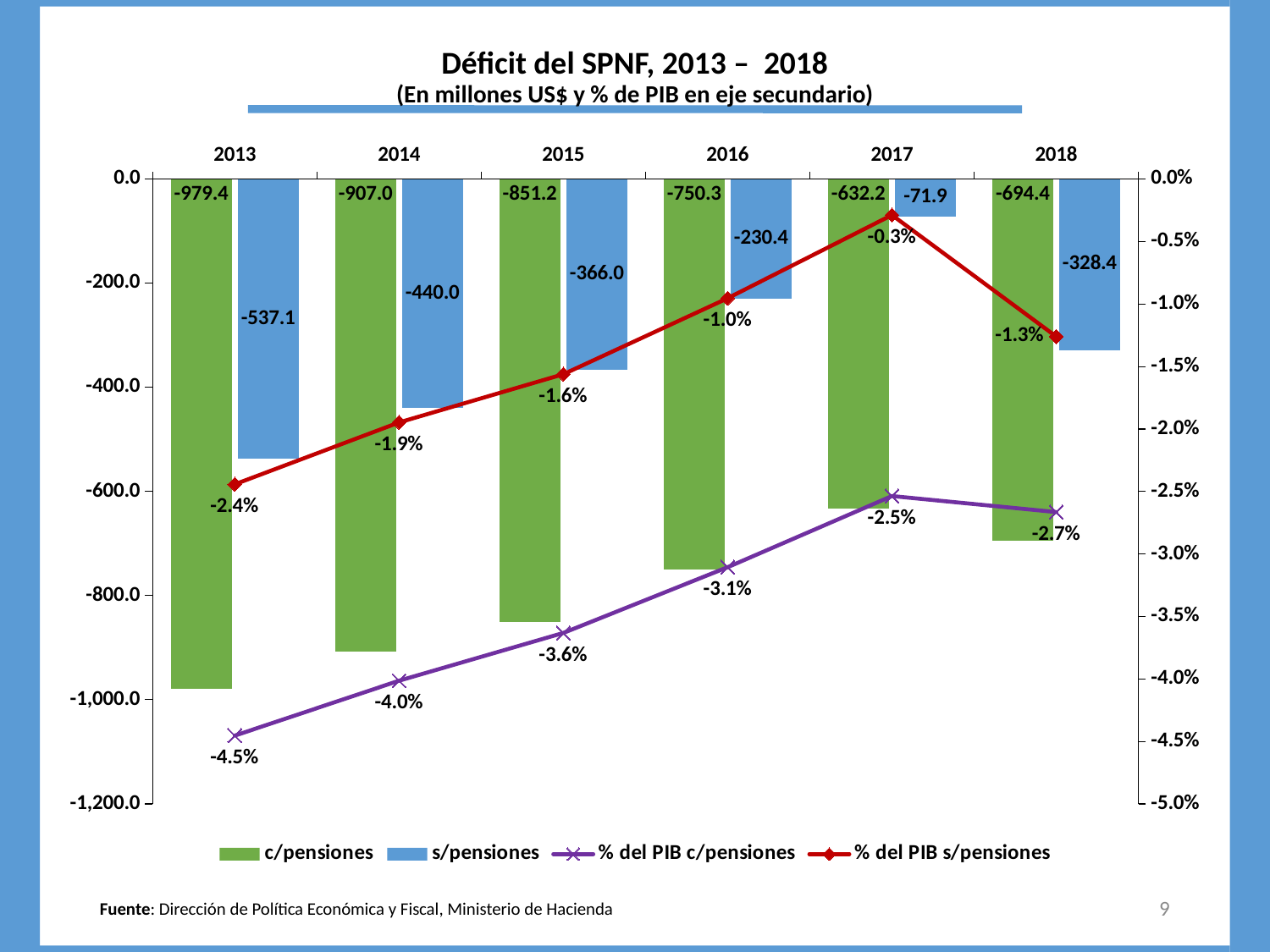
Which is further from zero in 2018, the c/pensiones bar or the s/pensiones bar? c/pensiones What is the value of s/pensiones for 2017? -71.9 What kind of chart is this? Combined bar and line chart What is the difference between the c/pensiones and s/pensiones values in 2016? 519.9 What is the % del PIB c/pensiones value for 2015? -3.6% In which year is the s/pensiones bar closest to zero (smallest deficit)? 2017 What is the % del PIB s/pensiones value for 2018? -1.3% From 2013 to 2017, does the % del PIB s/pensiones line rise or fall? rise How many years are shown on the x axis? 6 In which year is the c/pensiones bar furthest from zero (largest deficit)? 2013 How many series does the legend list? 4 What is the value of c/pensiones for 2013? -979.4